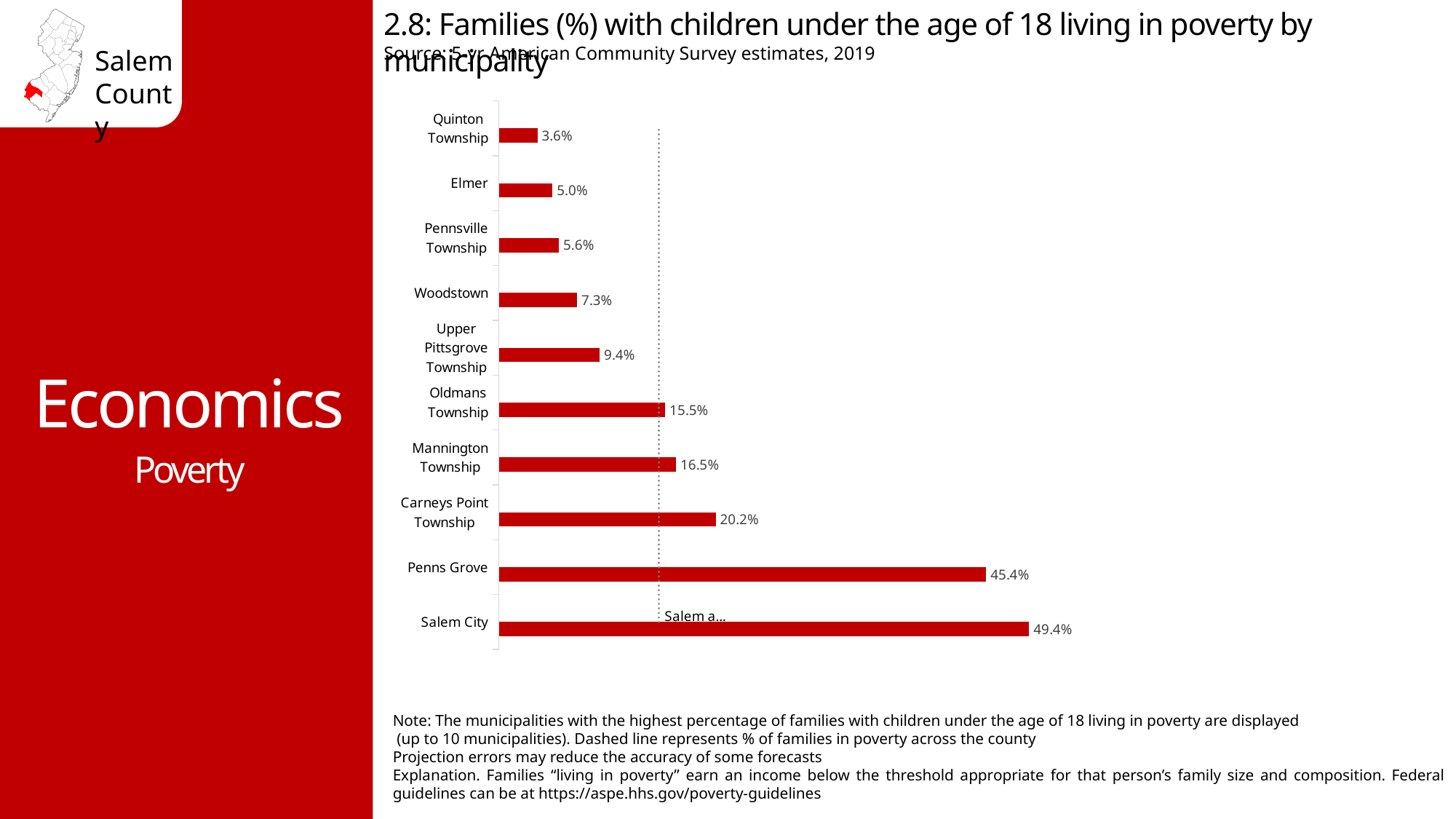
What percentage of families with children under 18 are living in poverty in Salem City? 49.4% What is the difference between the values for Mannington Township and Oldmans Township? 1.0% What is the value shown for Quinton Township? 3.6% What is the value shown for Carneys Point Township? 20.2% Which municipality has the lowest percentage shown on the chart? Quinton Township How many municipalities are shown on the chart? 10 What is the value shown for Penns Grove? 45.4% Which has a higher value, Woodstown or Upper Pittsgrove Township? Upper Pittsgrove Township What is the difference between the values for Salem City and Penns Grove? 4.0% According to the note, what does the dashed line on the chart represent? % of families in poverty across the county Which municipality has the highest percentage of families with children under 18 living in poverty? Salem City What type of chart is shown on the slide? Bar chart